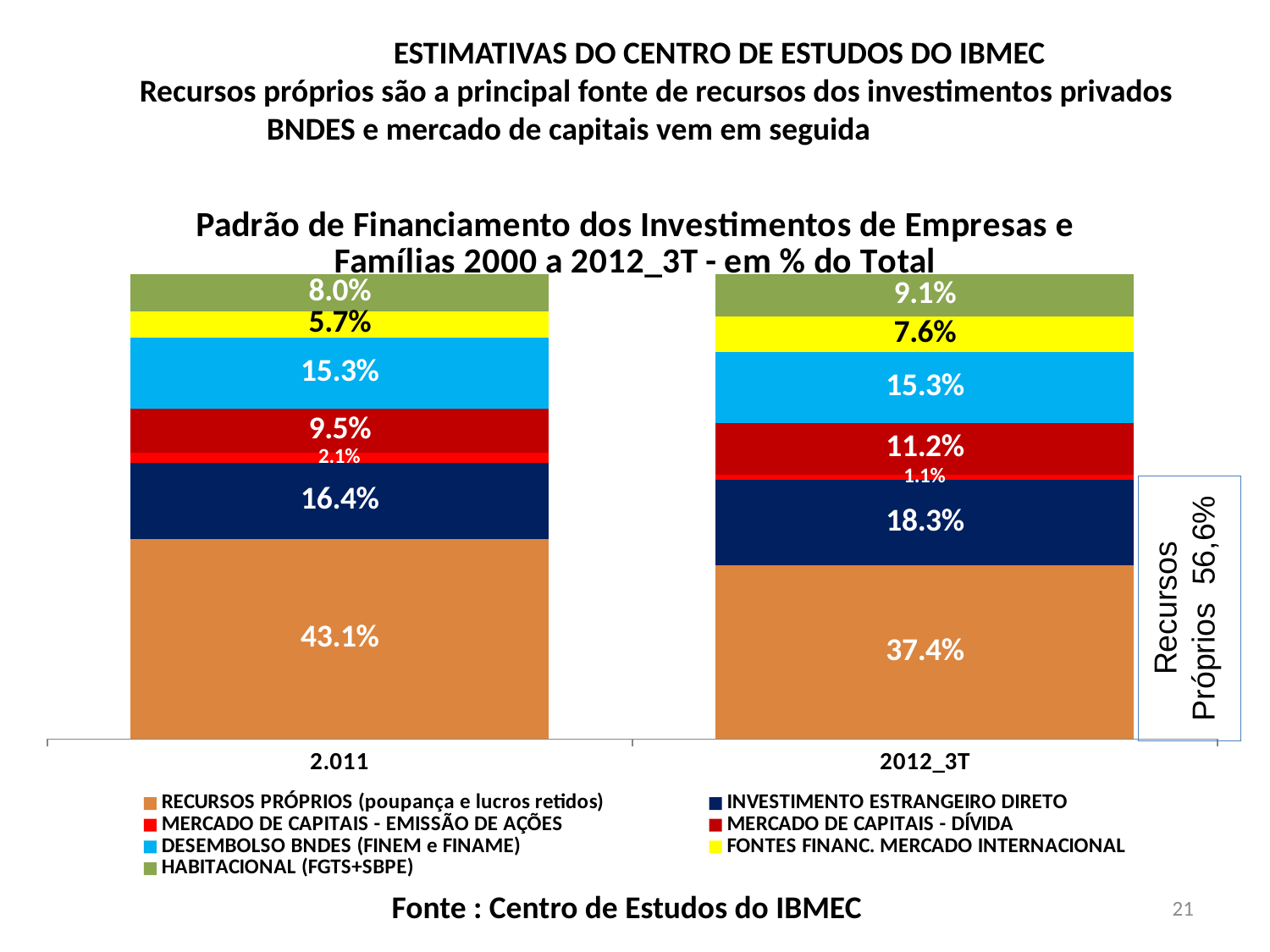
What is the difference between the RECURSOS PRÓPRIOS values for 2.011 and 2012_3T? 5.7% Which series has the largest share in the 2012_3T bar? RECURSOS PRÓPRIOS (poupança e lucros retidos) What is the value for INVESTIMENTO ESTRANGEIRO DIRETO in 2012_3T? 18.3% What is the value for MERCADO DE CAPITAIS - DÍVIDA in 2.011? 9.5% What kind of chart is shown on the slide? Stacked bar chart What is the value for FONTES FINANC. MERCADO INTERNACIONAL in 2012_3T? 7.6% How many categories are shown on the x axis? 2 What is the value for RECURSOS PRÓPRIOS (poupança e lucros retidos) in 2.011? 43.1% Is the value for HABITACIONAL (FGTS+SBPE) larger in 2.011 or in 2012_3T? 2012_3T Which series has the smallest share in the 2.011 bar? MERCADO DE CAPITAIS - EMISSÃO DE AÇÕES What is the value for RECURSOS PRÓPRIOS (poupança e lucros retidos) in 2012_3T? 37.4% How many series does the legend list? 7